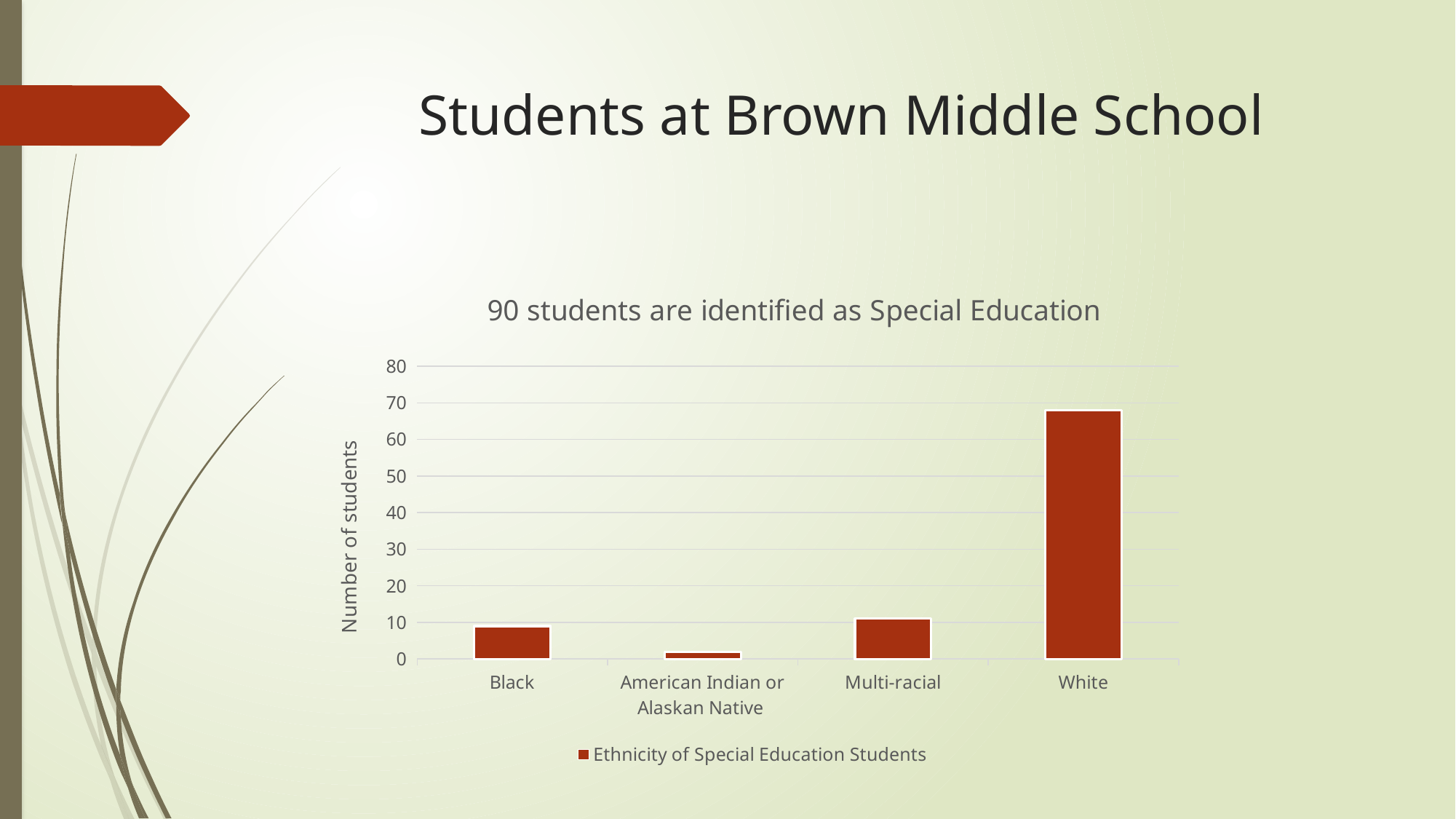
How many series does the legend list? 1 Which category has the lowest number of students? American Indian or Alaskan Native What is the label of the vertical axis? Number of students How many categories are shown on the x axis? 4 Which category has the highest number of students? White Which is larger, the value for White or the value for Black? White What kind of chart is shown on the slide? bar chart What is the title of the chart? 90 students are identified as Special Education Is the value for Multi-racial greater or less than 20? less Is the value for White greater or less than 60? greater